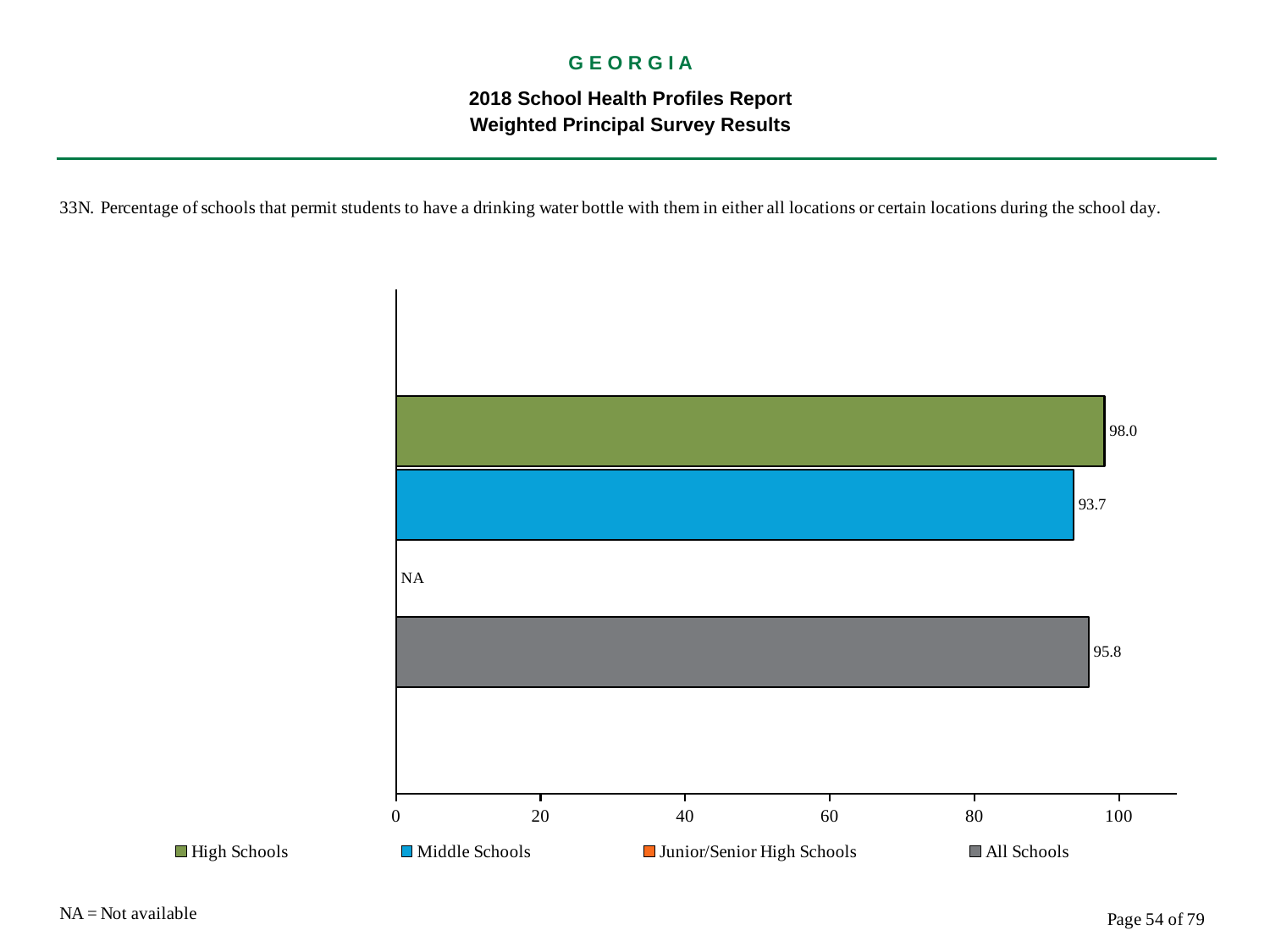
What is the difference between the values for All Schools and Middle Schools? 2.1 Which is larger, the value for All Schools or the value for Middle Schools? All Schools Among the school types with a plotted value, which has the lowest value? Middle Schools Is the value for Middle Schools greater or less than 80? greater What is the value for High Schools? 98.0 What is the difference between the values for High Schools and Middle Schools? 4.3 What is shown for Junior/Senior High Schools? NA What is the value for Middle Schools? 93.7 What kind of chart is shown on the slide? bar chart What is the value for All Schools? 95.8 Which school type has the highest value? High Schools How many series does the legend list? 4